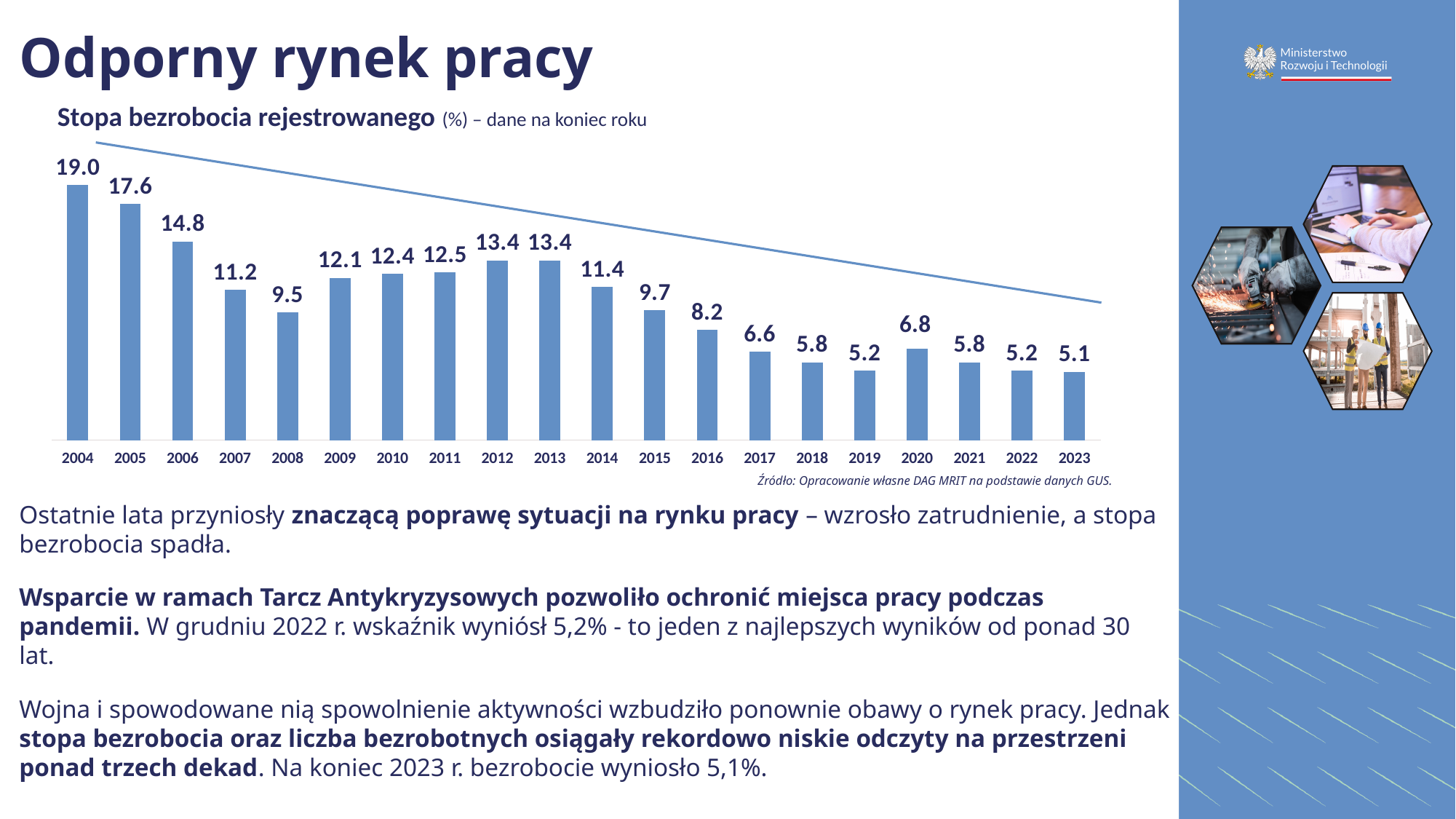
What kind of chart is shown on the slide? bar chart What is the difference between the values for 2019 and 2020? 1.6 Which year has the highest unemployment rate on the chart? 2004 Do the values generally rise or fall from 2004 to 2023? fall Which year has the lowest unemployment rate on the chart? 2023 What is the registered unemployment rate shown for 2004? 19.0 What is the difference between the values for 2004 and 2023? 13.9 What value is shown for 2020? 6.8 What is the value for 2023? 5.1 What is the title of the chart? Stopa bezrobocia rejestrowanego (%) – dane na koniec roku Which is larger, the value for 2008 or the value for 2015? 2015 How many years are shown on the x axis of the chart? 20